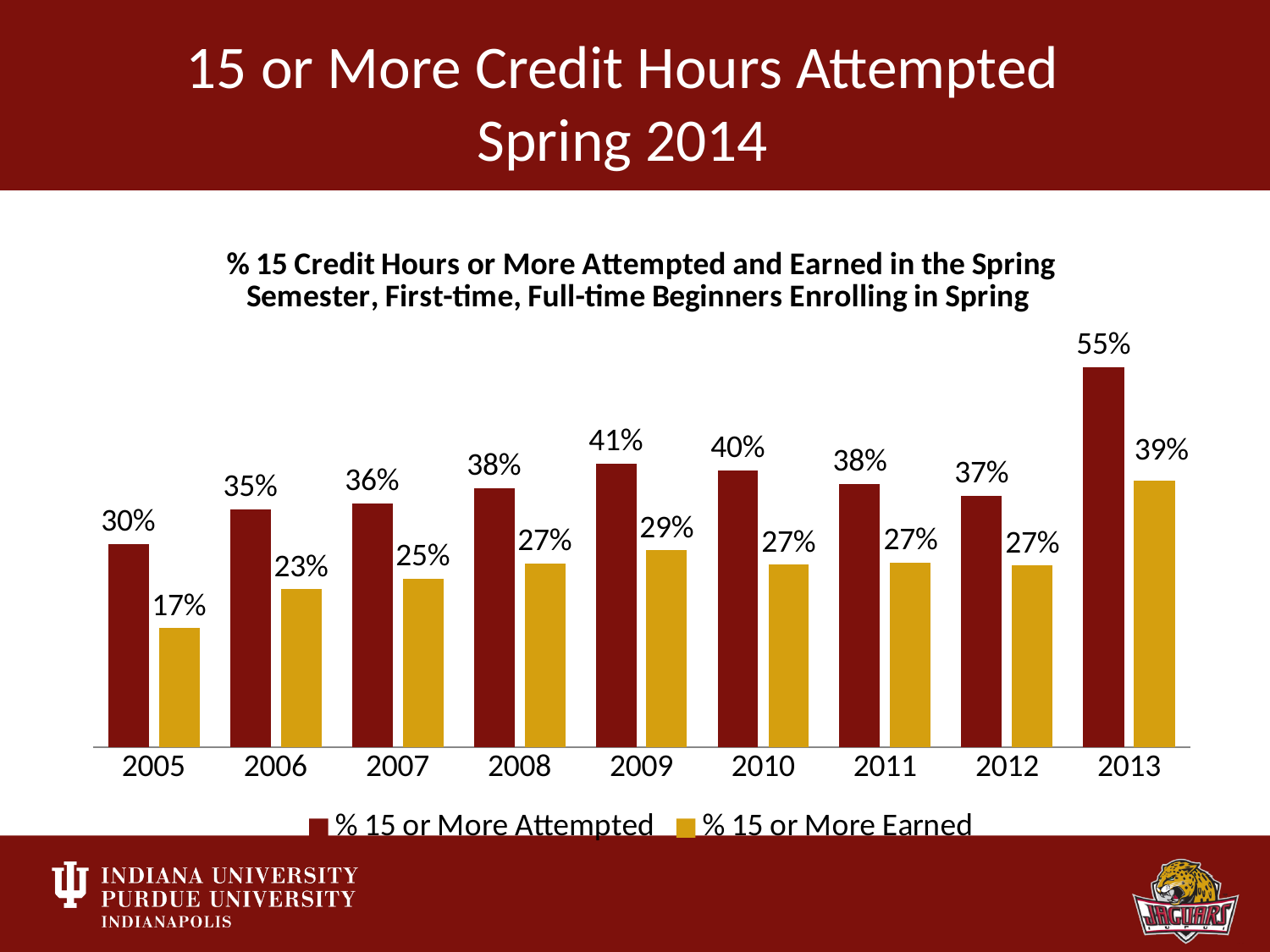
How many series does the legend list? 2 What is the value of % 15 or More Earned for 2005? 17% Which year has the lowest value for % 15 or More Earned? 2005 How many years are shown on the x axis? 9 Which year has the highest value for % 15 or More Attempted? 2013 What is the value of % 15 or More Attempted for 2013? 55% Which is larger: % 15 or More Attempted in 2009 or in 2011? 2009 What is the value of % 15 or More Earned for 2009? 29% What is the difference between % 15 or More Attempted in 2013 and in 2012? 18% What kind of chart is shown on the slide? Bar chart What is the difference between % 15 or More Attempted and % 15 or More Earned in 2013? 16% Which colour represents % 15 or More Earned in the chart? Gold